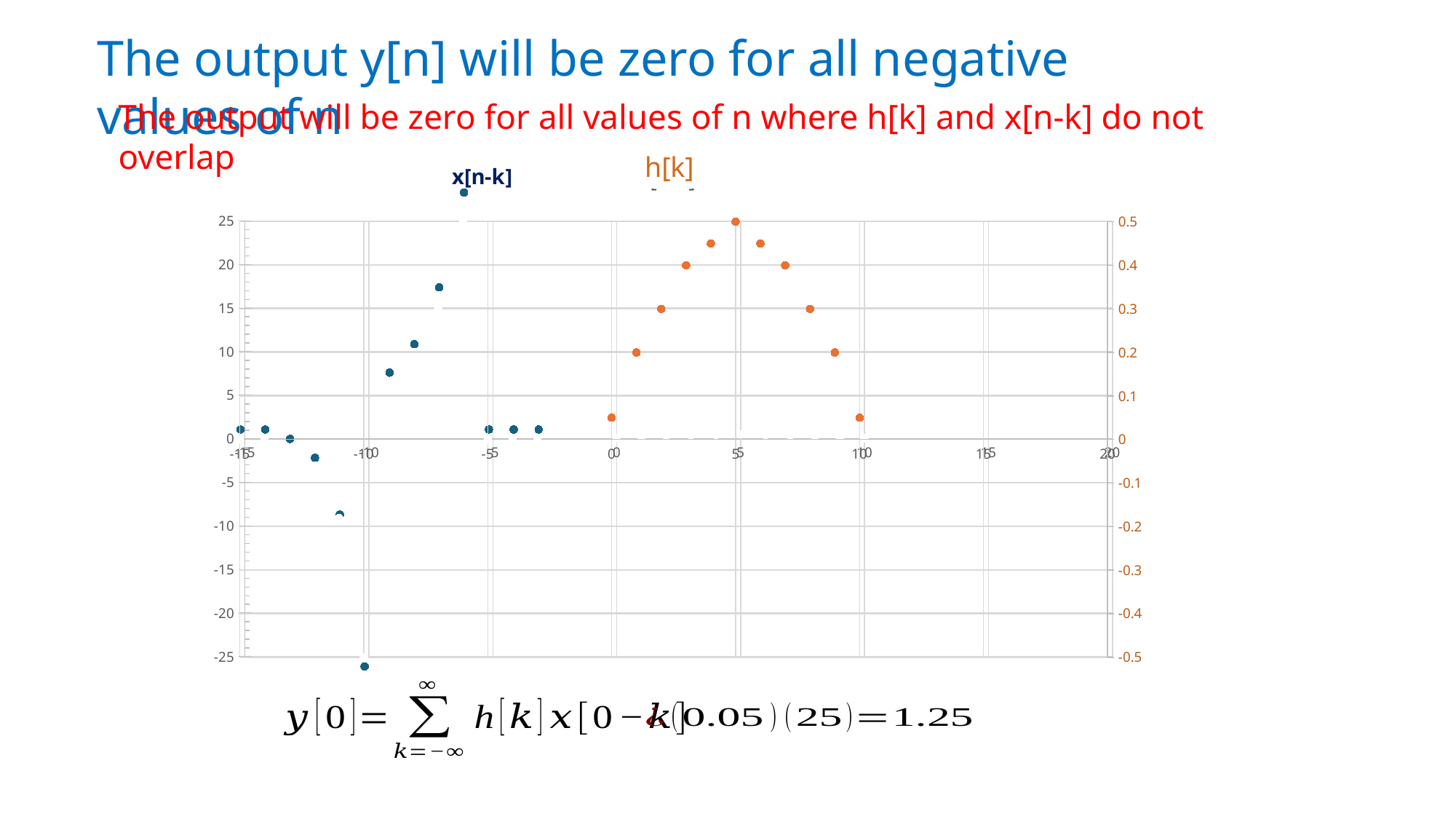
What is the value of h[k] at k = 9 on the right-hand axis? 0.2 Which is larger: h[k] at k = 5 or h[k] at k = 1? k = 5 At which value of k does the h[k] series reach its highest value? 5 What is the value of h[k] at k = 3 on the right-hand axis? 0.4 What is the difference between h[k] at k = 5 and h[k] at k = 1? 0.3 How many points does the h[k] series have? 11 How many series are plotted on the chart? 2 What are the names of the two series on the chart? x[n-k] and h[k] What is the value of h[k] at k = 5 on the right-hand axis? 0.5 What kind of chart is shown on the slide? scatter chart